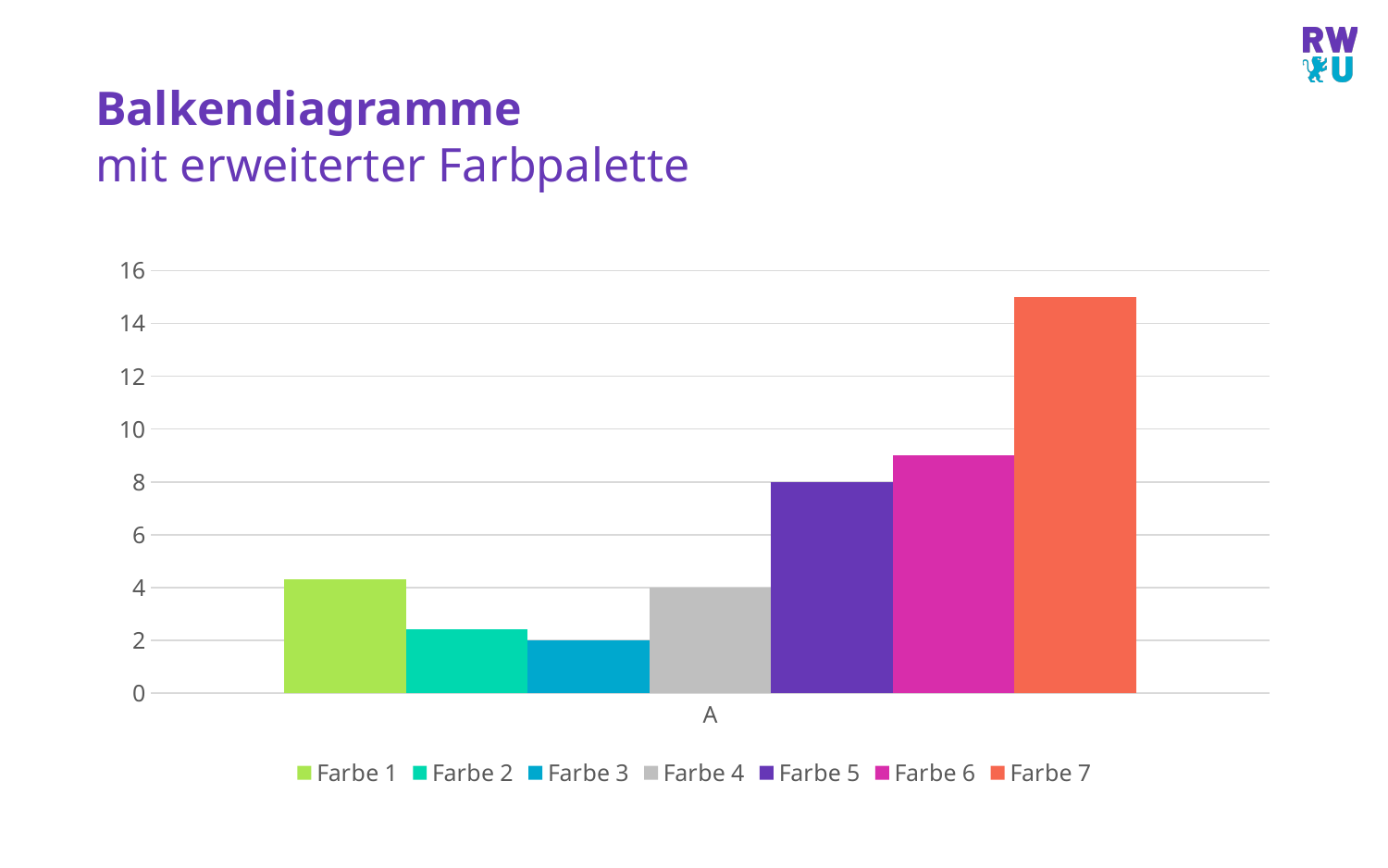
What type of chart is shown on the slide? bar chart Which series has the lowest value for category A? Farbe 3 What is the value for Farbe 4 in category A? 4 How many categories are shown on the x axis? 1 Which series has the highest value for category A? Farbe 7 What is the value for Farbe 5 in category A? 8 How many series does the legend list? 7 What is the title of the slide containing the chart? Balkendiagramme mit erweiterter Farbpalette What is the value for Farbe 3 in category A? 2 What is the difference between the values for Farbe 5 and Farbe 3? 6 Is the value for Farbe 7 greater or less than 14? greater Which is larger, the value for Farbe 1 or the value for Farbe 2? Farbe 1